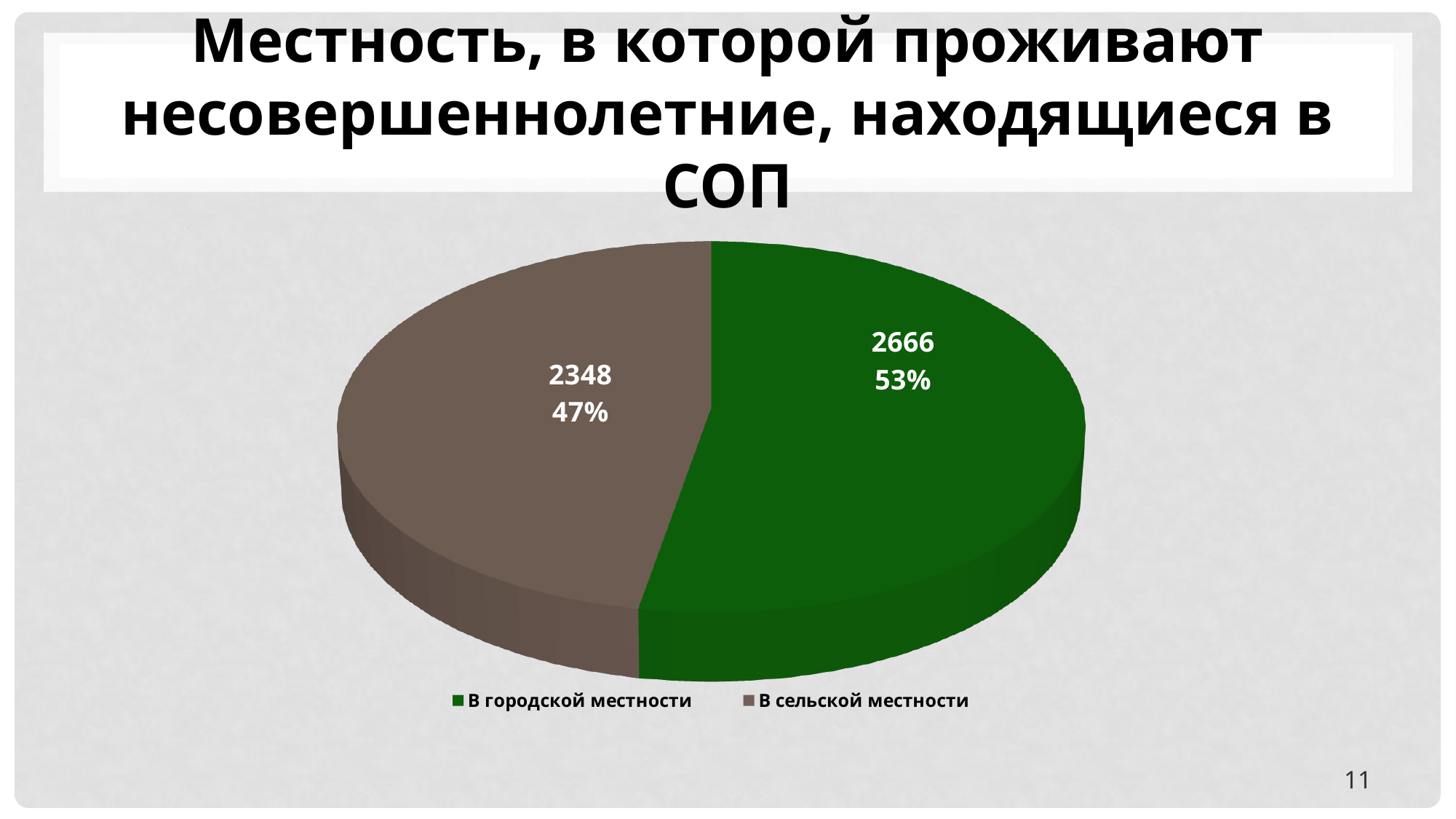
What share of the pie does 'В городской местности' represent? 53% What type of chart is shown on the slide? pie chart What is the difference between the values for 'В городской местности' and 'В сельской местности'? 318 Which category has the largest slice? В городской местности Which category has the smallest slice? В сельской местности What colour is the slice for 'В сельской местности'? brown Which is larger: the value for 'В городской местности' or 'В сельской местности'? В городской местности What is the value for 'В городской местности'? 2666 What is the value for 'В сельской местности'? 2348 How many entries does the legend list? 2 How many slices does the pie chart have? 2 What share of the pie does 'В сельской местности' represent? 47%